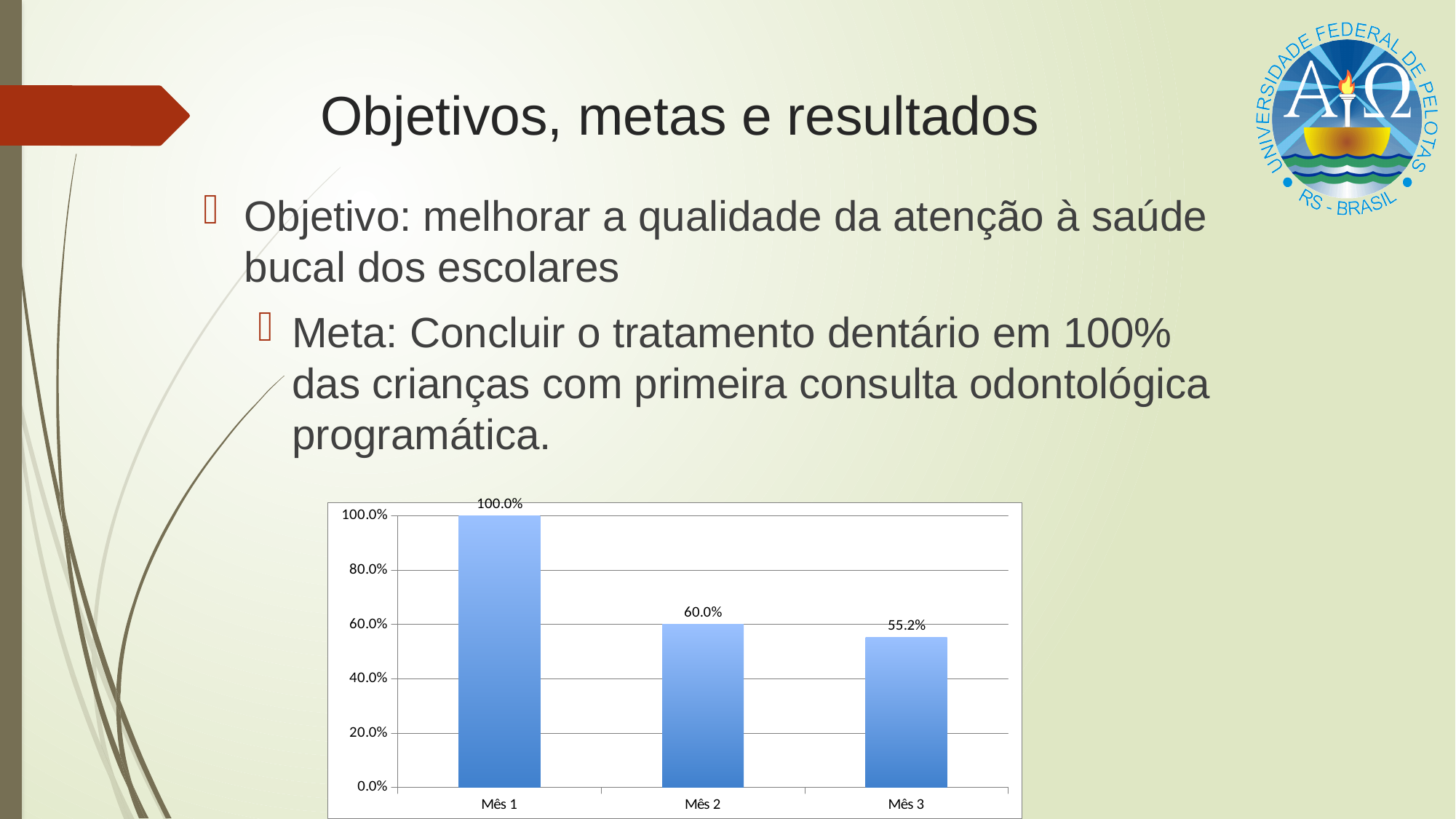
What is the difference between the values for Mês 1 and Mês 2? 40.0% Is the value for Mês 3 greater or less than 60.0%? less What is the value for Mês 1? 100.0% What kind of chart is shown on the slide? bar chart What is the difference between the values for Mês 2 and Mês 3? 4.8% What is the value for Mês 2? 60.0% Which is larger, the value for Mês 2 or the value for Mês 3? Mês 2 How many categories are shown on the x axis? 3 Which category has the lowest value? Mês 3 Do the values rise or fall from Mês 1 to Mês 3? fall What is the value for Mês 3? 55.2% Which category has the highest value? Mês 1